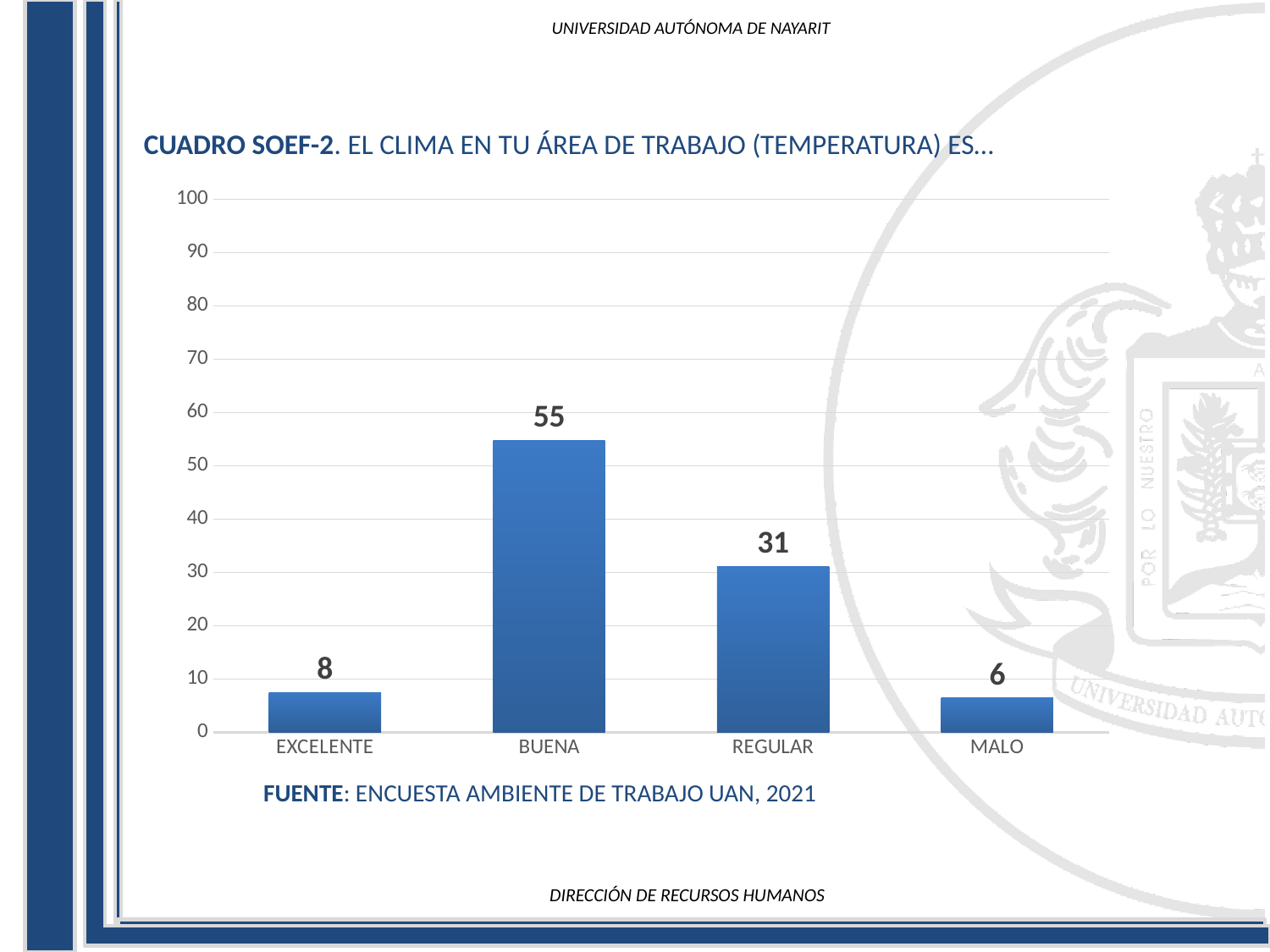
Which category has the lowest value? MALO What is the highest value shown on the y axis? 100 Is the value for REGULAR greater or less than 40? less What is the value for EXCELENTE? 8 Which category has the highest value? BUENA What is the source cited below the chart? ENCUESTA AMBIENTE DE TRABAJO UAN, 2021 What kind of chart is shown on the slide? bar chart How many categories are shown on the x axis? 4 Which is larger, the value for REGULAR or the value for EXCELENTE? REGULAR What is the difference between the values for BUENA and REGULAR? 24 What is the value for BUENA? 55 What is the value for MALO? 6